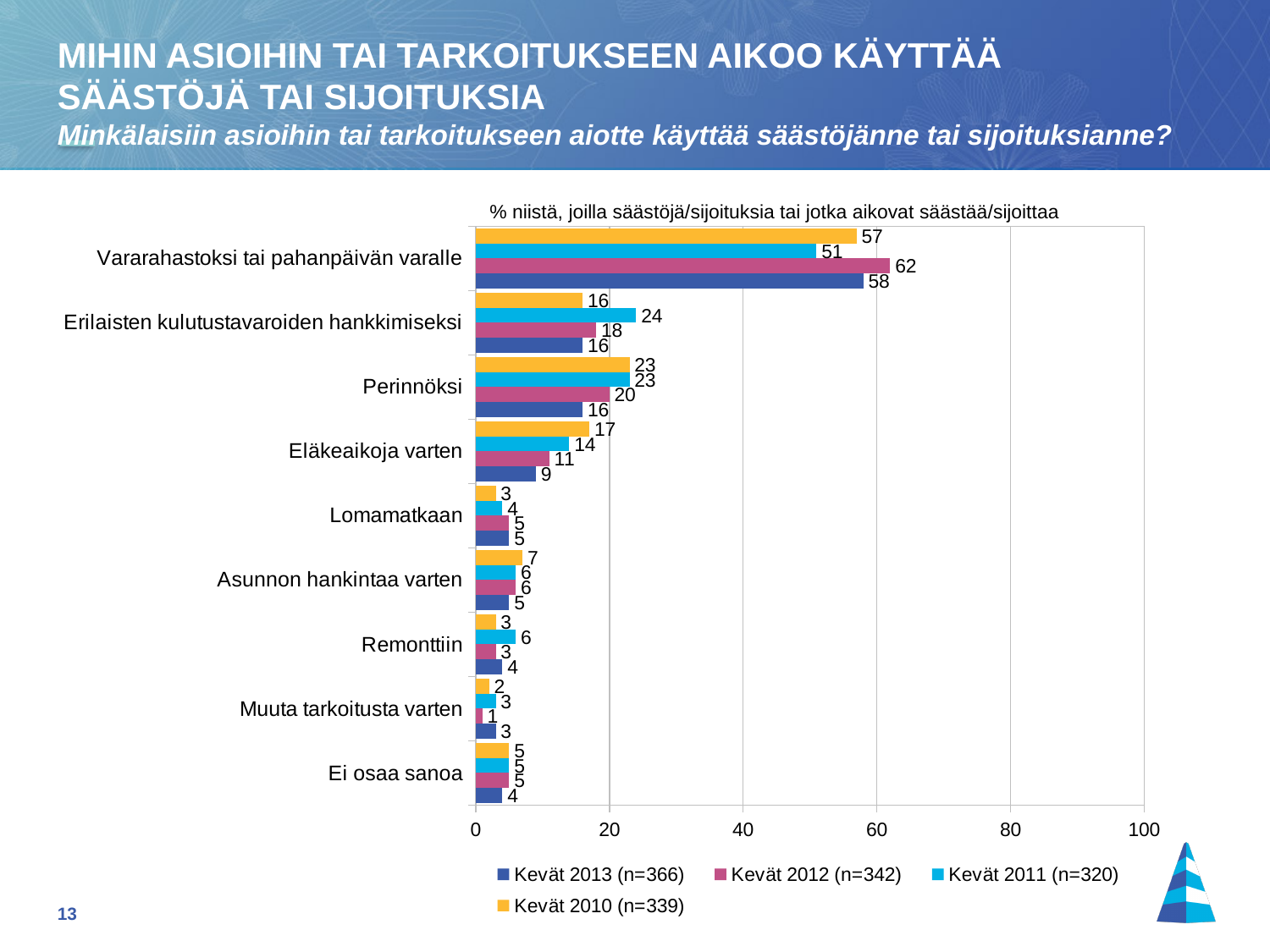
How many categories are shown on the chart? 9 Which category has the lowest value in the Kevät 2012 (n=342) series? Muuta tarkoitusta varten What kind of chart is shown on the slide? Bar chart What is the value for Vararahastoksi tai pahanpäivän varalle in the Kevät 2012 (n=342) series? 62 How many series does the legend list? 4 What is the difference between the Kevät 2012 (n=342) and Kevät 2011 (n=320) values for Vararahastoksi tai pahanpäivän varalle? 11 What is the value for Perinnöksi in the Kevät 2010 (n=339) series? 23 Which category has the highest value in the Kevät 2013 (n=366) series? Vararahastoksi tai pahanpäivän varalle Which is larger for Eläkeaikoja varten: the Kevät 2010 (n=339) value or the Kevät 2013 (n=366) value? Kevät 2010 (n=339) What is the value for Erilaisten kulutustavaroiden hankkimiseksi in the Kevät 2011 (n=320) series? 24 Is the value for Vararahastoksi tai pahanpäivän varalle in the Kevät 2013 (n=366) series greater or less than 40? greater What is the value for Eläkeaikoja varten in the Kevät 2013 (n=366) series? 9